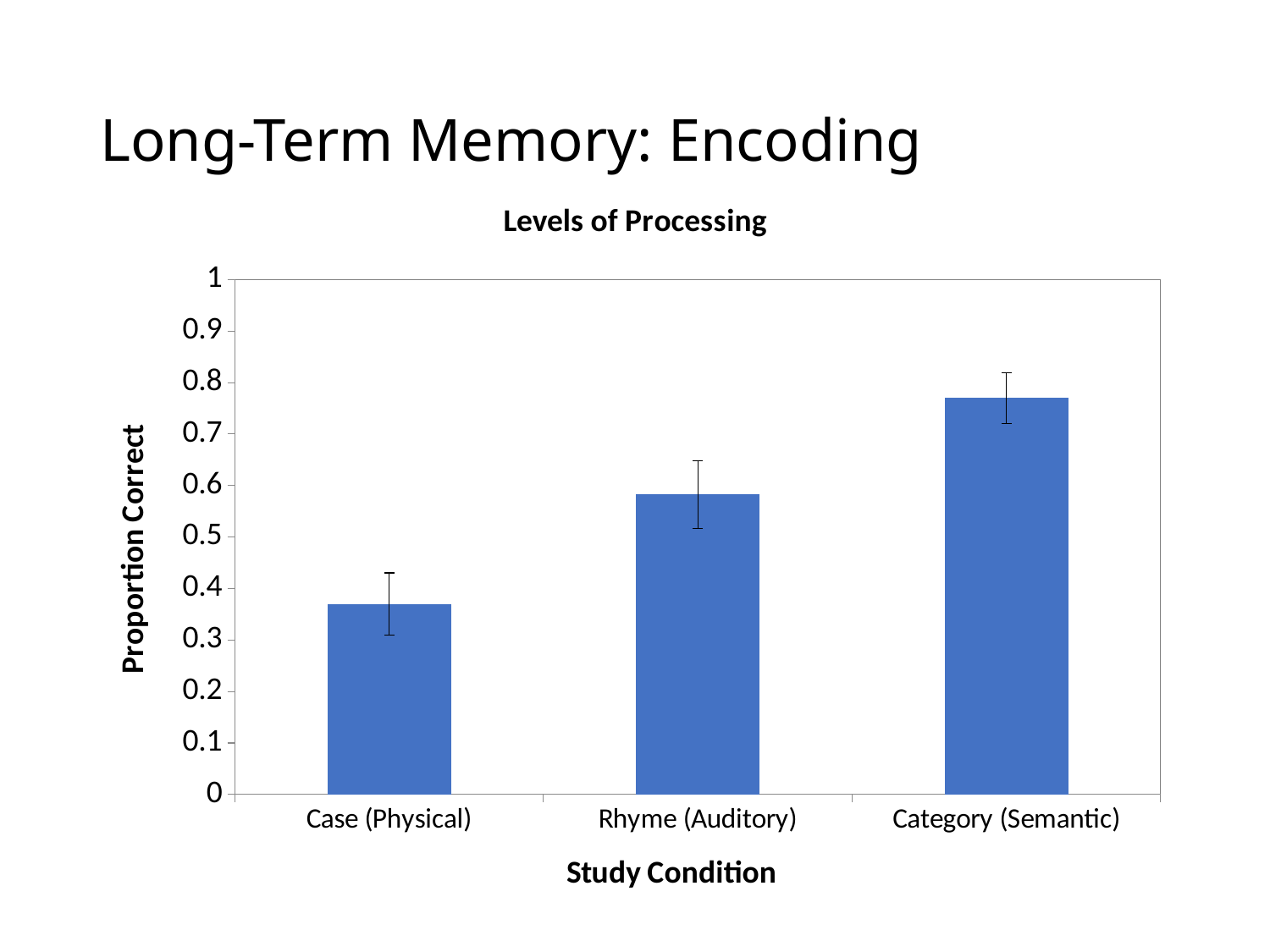
Is the value for Rhyme (Auditory) greater or less than 0.5? greater Which study condition has the highest proportion correct? Category (Semantic) Which has a higher proportion correct, Category (Semantic) or Rhyme (Auditory)? Category (Semantic) Is the value for Case (Physical) greater or less than 0.5? less What kind of chart is shown on the slide? bar chart How many study conditions are plotted on the chart? 3 Which has a higher proportion correct, Rhyme (Auditory) or Case (Physical)? Rhyme (Auditory) Which study condition has the lowest proportion correct? Case (Physical) Is the value for Category (Semantic) greater or less than 0.9? less What is the title of the chart? Levels of Processing Do the values rise or fall moving from Case (Physical) to Category (Semantic) along the x axis? rise